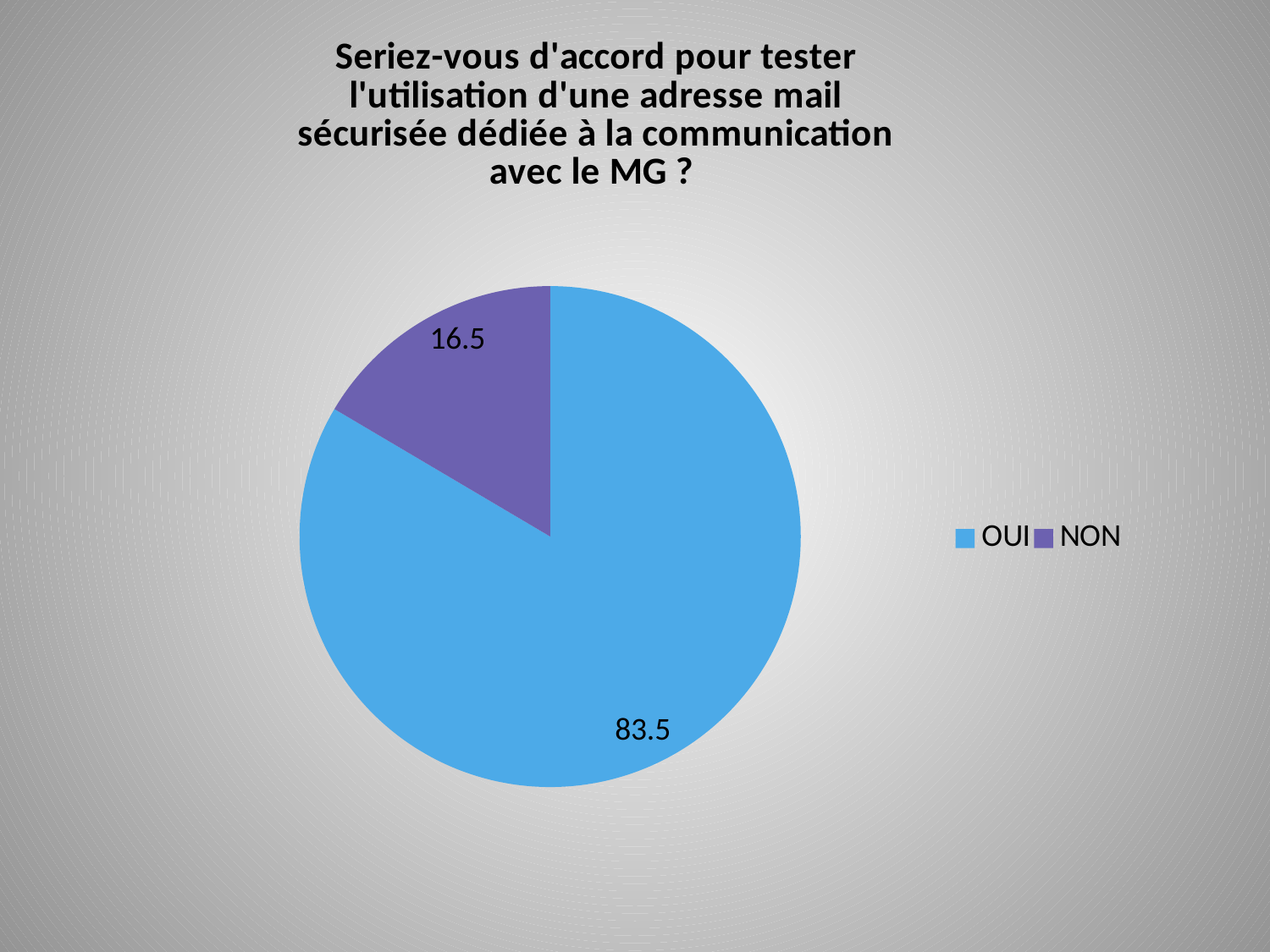
What is the total of the two values shown on the pie chart? 100 Which is larger, the value for OUI or the value for NON? OUI What is the value shown for NON? 16.5 What type of chart is shown on the slide? pie chart Which category has the largest slice? OUI What is the difference between the values for OUI and NON? 67 Which category has the smallest slice? NON How many slices does the pie chart have? 2 How many entries does the legend list? 2 What colour is the slice for NON? purple What is the value shown for OUI? 83.5 What colour is the slice for OUI? blue